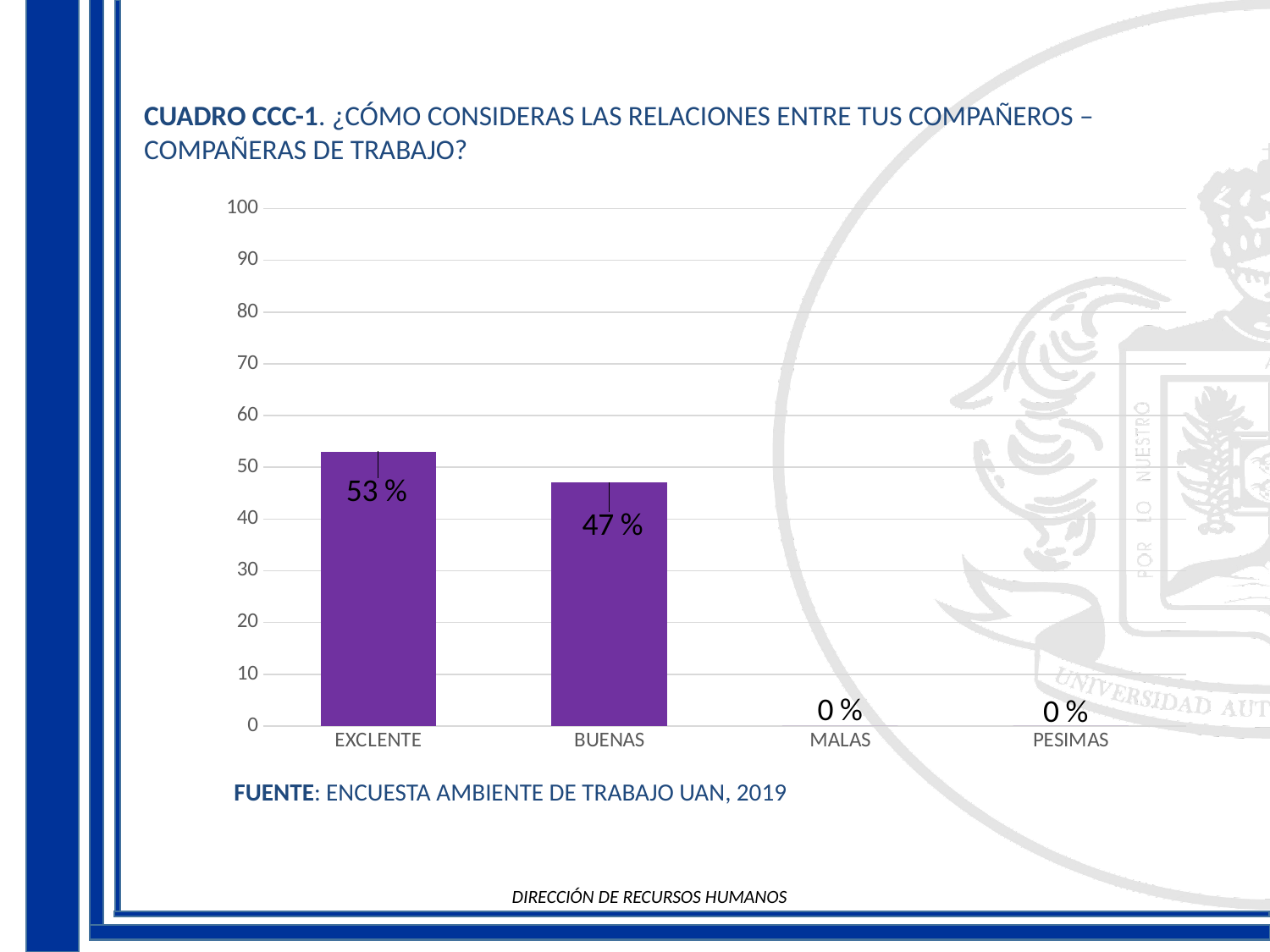
How many categories are shown on the x axis? 4 What is the value for EXCLENTE? 53 % Which category has the highest value? EXCLENTE What is the value for PESIMAS? 0 % Is the value for EXCLENTE greater or less than 50? greater Is the value for BUENAS greater or less than 50? less What kind of chart is shown on the slide? bar chart What is the value for BUENAS? 47 % What is the difference between the values for EXCLENTE and BUENAS? 6 % Which is larger, the value for EXCLENTE or the value for BUENAS? EXCLENTE What is the value for MALAS? 0 % What is the source cited below the chart? ENCUESTA AMBIENTE DE TRABAJO UAN, 2019